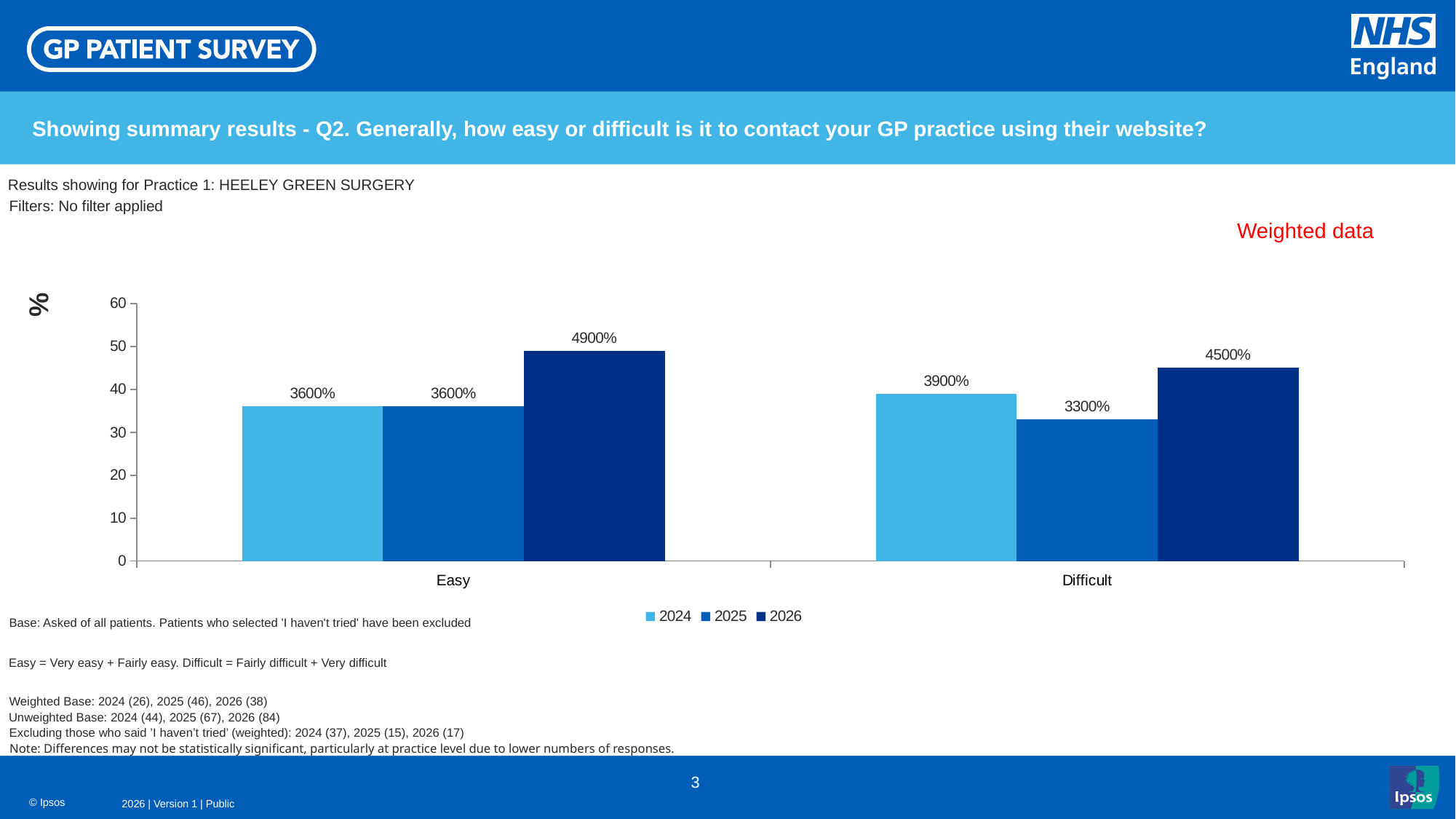
What is the data label for 2024 in the Easy category? 3600% How many categories are shown on the x axis? 2 What is the data label for 2025 in the Difficult category? 3300% What is the data label for 2026 in the Easy category? 4900% Is the 2026 bar in the Difficult category greater or less than 40 on the axis? greater Which year has the lowest bar in the Difficult category? 2025 How many series does the legend list? 3 Which is larger in the Difficult category, the 2024 bar or the 2026 bar? 2026 What type of chart is shown on the slide? bar chart Which year has the highest bar in the Easy category? 2026 Which years are listed in the chart legend? 2024, 2025, 2026 What is the data label for 2024 in the Difficult category? 3900%